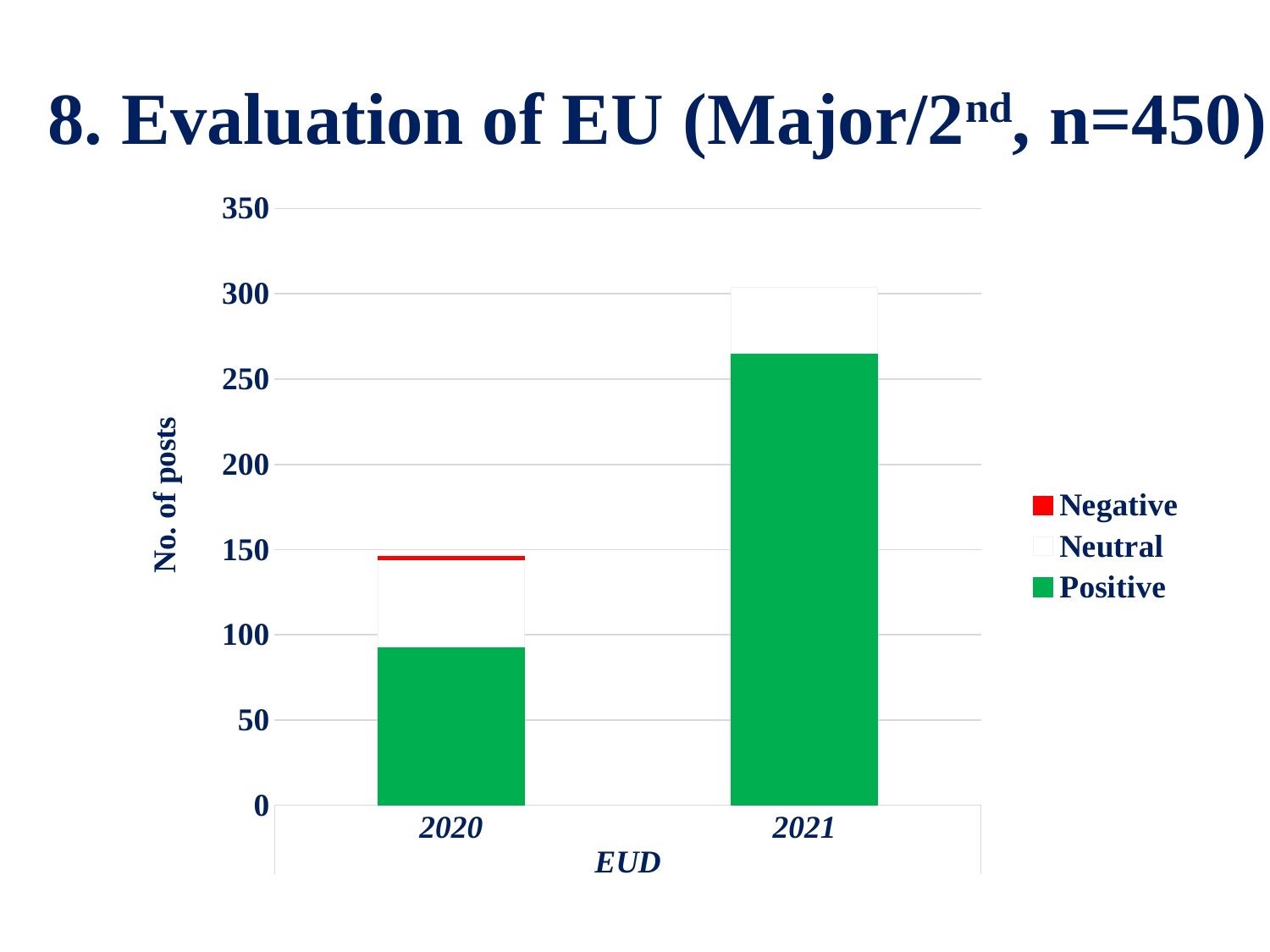
Do the total values rise or fall from 2020 to 2021? rise How many series does the legend list? 3 Is the total height of the 2021 stacked bar greater or less than 250? greater What is the title of the y axis? No. of posts Is the Positive value for 2020 greater or less than 100? less Which colour represents the Positive series in the legend? green How many categories are shown on the x axis? 2 Which year has the highest total number of posts? 2021 Which year has the taller stacked bar, 2020 or 2021? 2021 What kind of chart is shown on the slide? bar chart Is the Positive value for 2021 greater or less than 250? greater